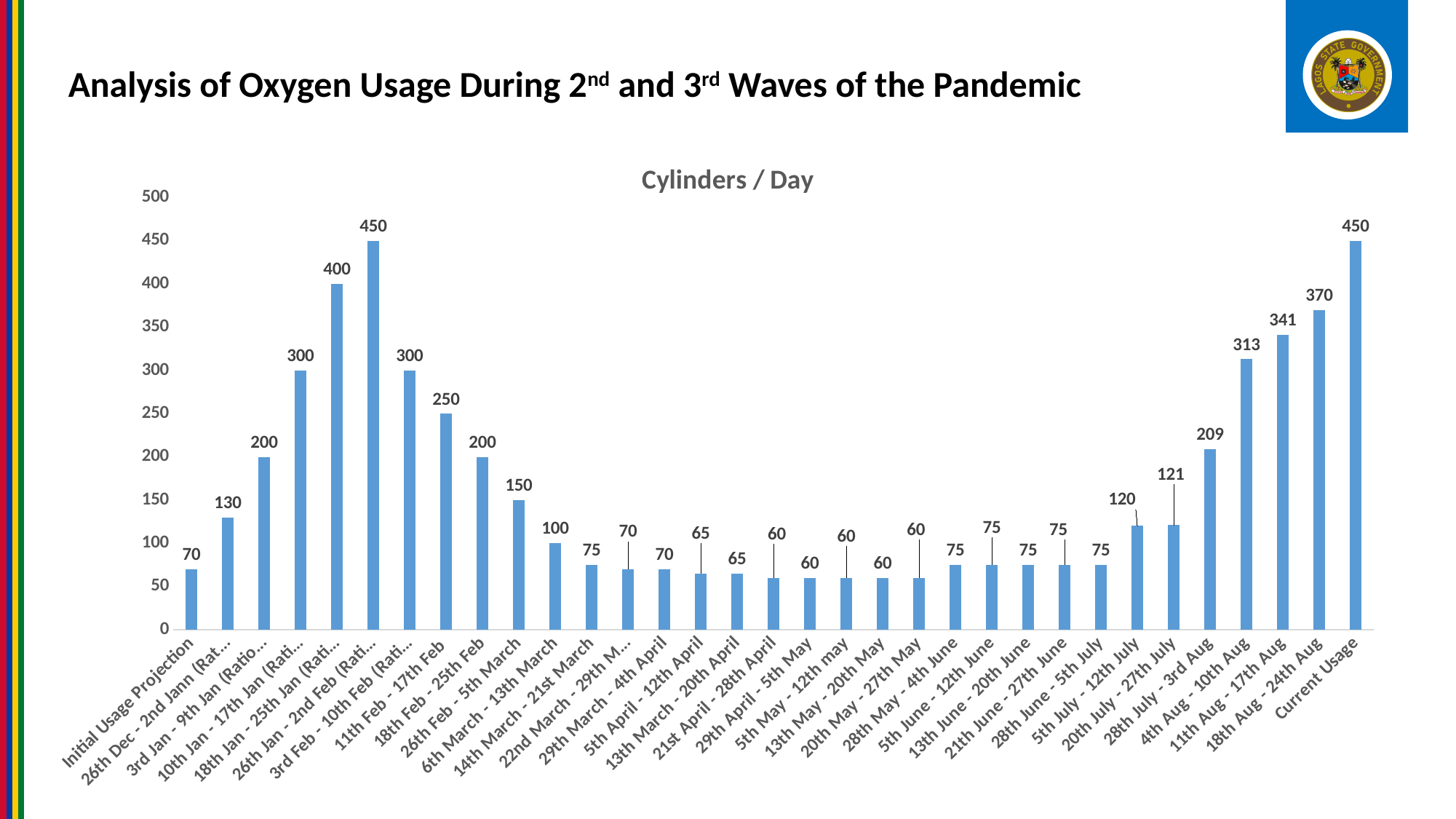
How many bars are plotted on the chart? 33 Do the values rise or fall from 5th July - 12th July to Current Usage? rise What is the title of the chart? Cylinders / Day What is the value for 28th July - 3rd Aug? 209 What type of chart is shown on the slide? bar chart What is the value for Initial Usage Projection? 70 What is the highest value shown on the chart? 450 What is the value for 11th Aug - 17th Aug? 341 What is the value for Current Usage? 450 What is the difference between the values for 18th Aug - 24th Aug and 4th Aug - 10th Aug? 57 Which is larger, the value for 11th Feb - 17th Feb or the value for 26th Feb - 5th March? 11th Feb - 17th Feb What is the lowest value shown on the chart? 60